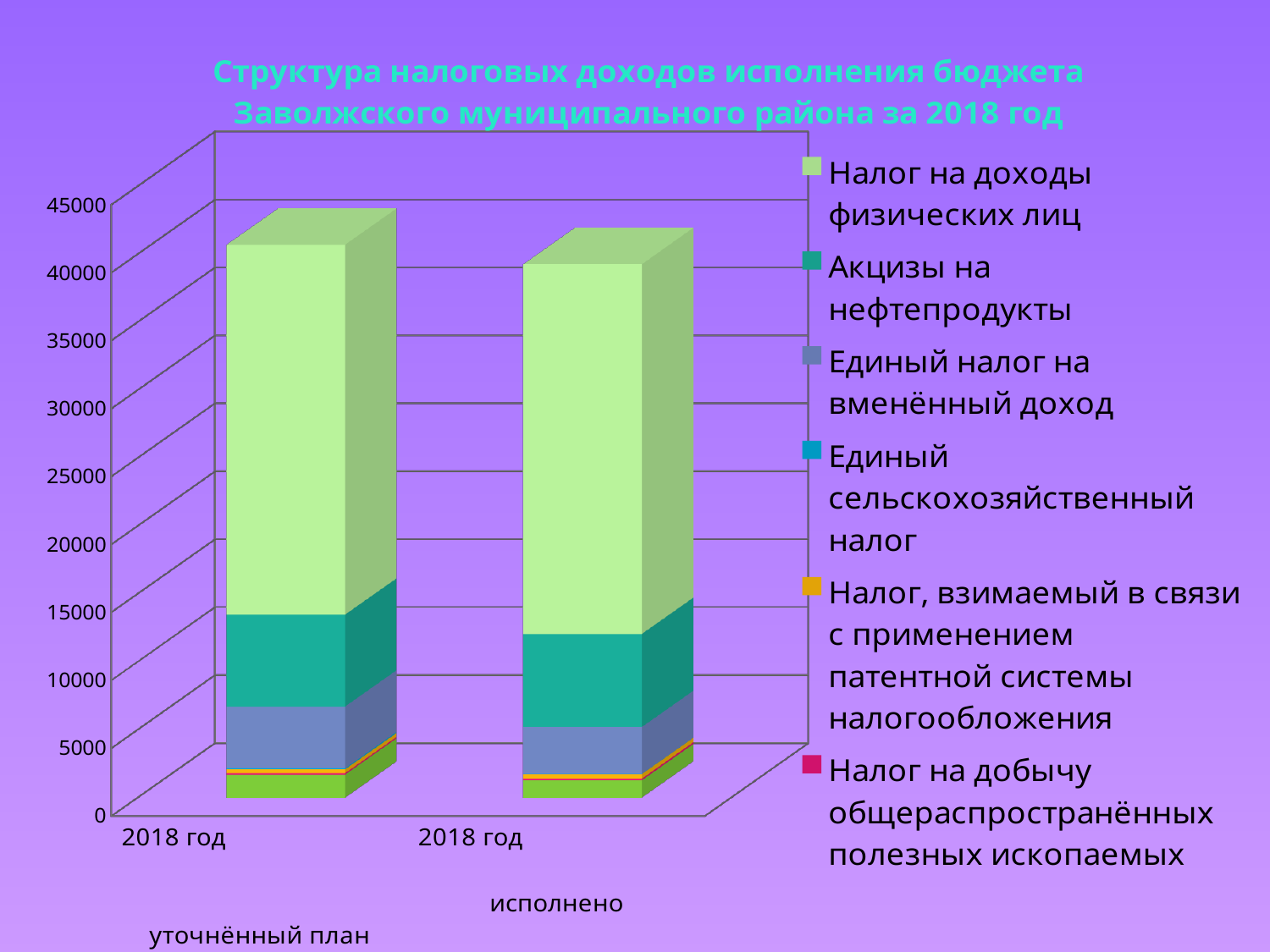
What is the title of the chart? Структура налоговых доходов исполнения бюджета Заволжского муниципального района за 2018 год How many bars are plotted in the chart? 2 What is the highest value shown on the vertical axis? 45000 Which series forms the largest segment of the 'исполнено' bar? Налог на доходы физических лиц Which series forms the largest segment of the 'уточнённый план' bar? Налог на доходы физических лиц What kind of chart is shown on the slide? stacked bar chart Is the total of the 'исполнено' bar greater or less than 45000? less Which series is shown in orange in the legend? Налог, взимаемый в связи с применением патентной системы налогообложения Is the total of the 'исполнено' bar greater or less than 30000? greater How many series does the legend list? 6 Is the total of the 'уточнённый план' bar greater or less than 35000? greater In the 'уточнённый план' bar, which segment is larger: 'Акцизы на нефтепродукты' or 'Единый налог на вменённый доход'? Акцизы на нефтепродукты